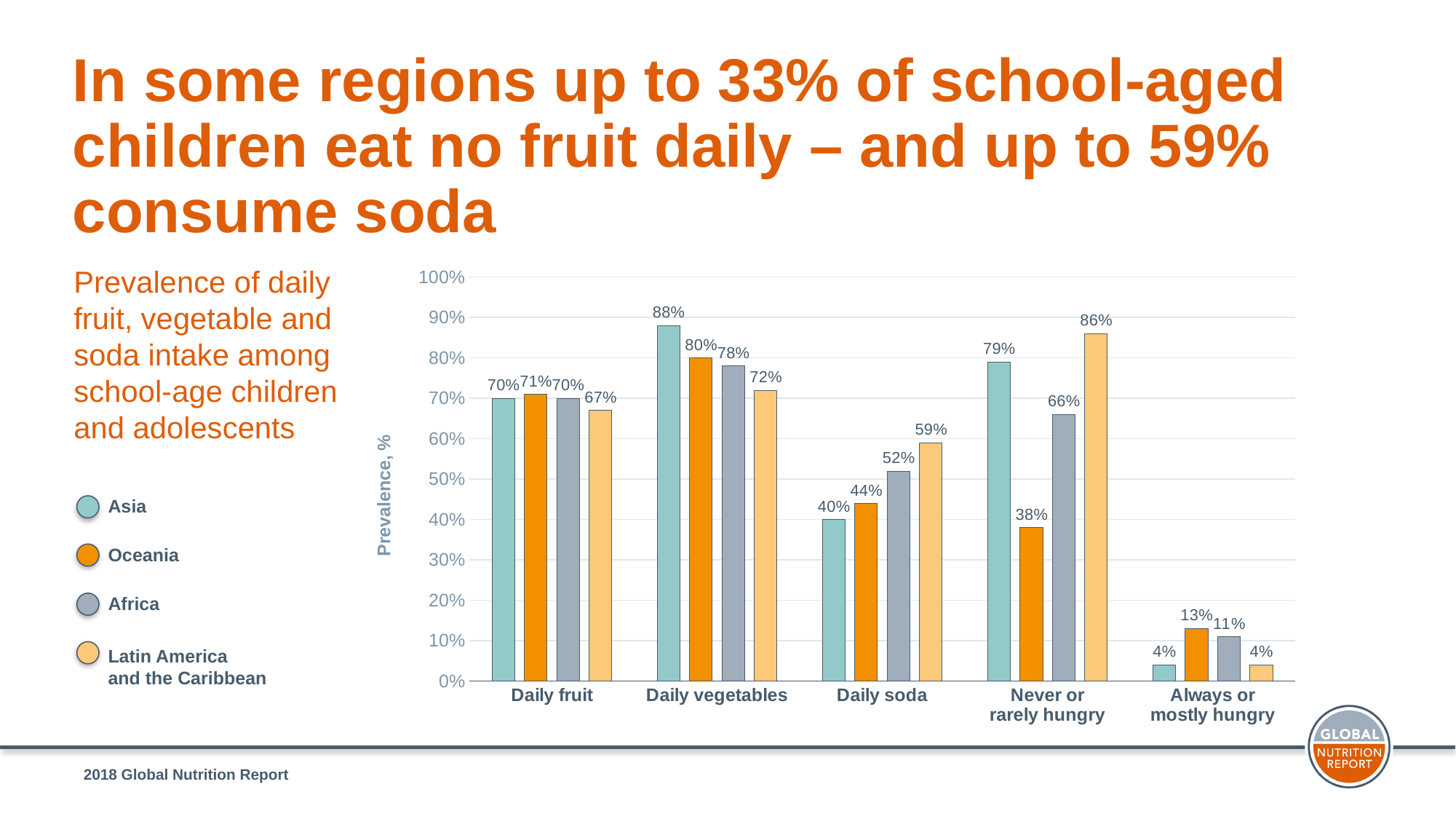
Which region has the lowest value in the Never or rarely hungry category? Oceania What is the label of the y axis? Prevalence, % How many categories are shown on the x axis? 5 What is the value for Latin America and the Caribbean in the Never or rarely hungry category? 86% Which is larger in the Daily vegetables category: the value for Africa or the value for Latin America and the Caribbean? Africa What is the value for Asia in the Daily vegetables category? 88% Which region has the highest value in the Daily soda category? Latin America and the Caribbean What kind of chart is shown on the slide? bar chart How many series does the legend list? 4 What is the value for Oceania in the Daily soda category? 44% What is the difference between the Asia and Oceania values in the Never or rarely hungry category? 41% Is the value for Africa in the Daily soda category greater or less than 50%? greater